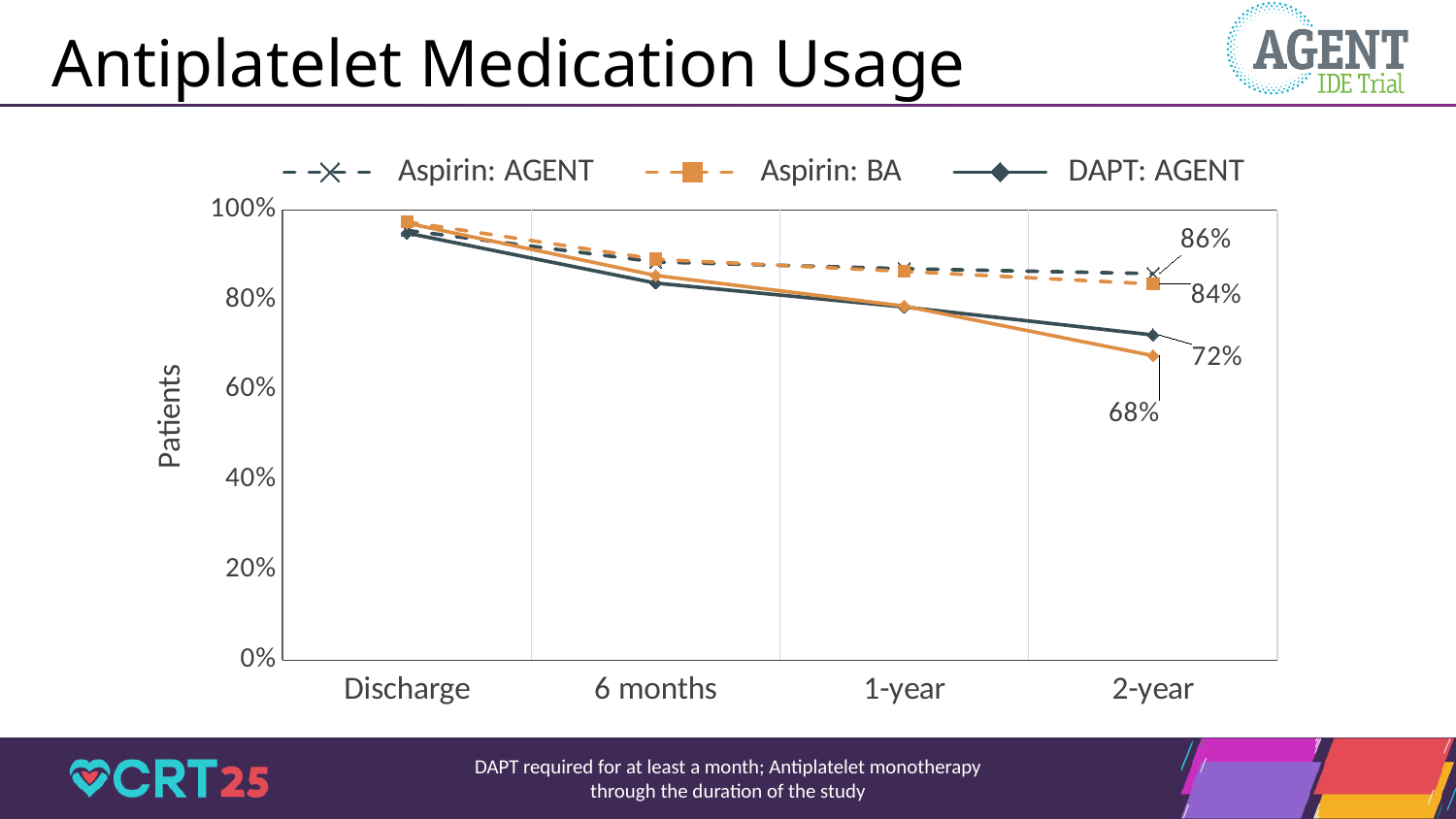
Does the DAPT: AGENT line rise or fall from Discharge to 2-year? fall What is the value for DAPT: AGENT at 2-year? 72% Is the value for DAPT: AGENT at Discharge greater or less than 80%? greater At 2-year, what is the difference between Aspirin: AGENT and Aspirin: BA? 2 percentage points What is the label on the y axis? Patients What is the value for Aspirin: BA at 2-year? 84% How many series does the legend list? 3 At 2-year, what is the difference between Aspirin: AGENT and DAPT: AGENT? 14 percentage points What kind of chart is shown on the slide? line chart How many time points are shown on the x axis? 4 At 2-year, which is larger: Aspirin: AGENT or DAPT: AGENT? Aspirin: AGENT What is the value for Aspirin: AGENT at 2-year? 86%